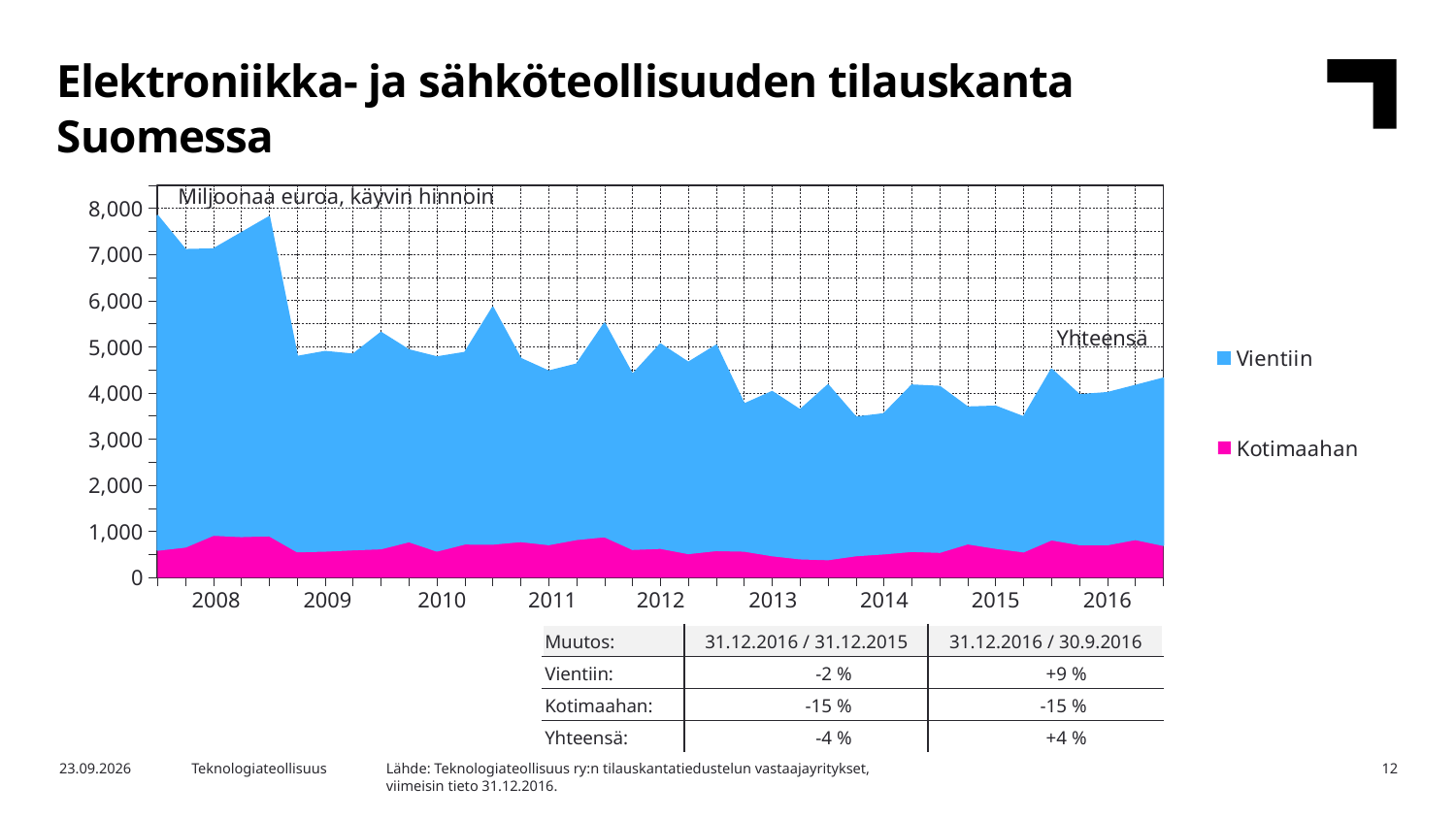
According to the table below the chart, what is the change for Yhteensä between 30.9.2016 and 31.12.2016? +4 % How many series does the chart legend list? 2 Does the total order backlog (Yhteensä) generally rise or fall from 2008 to 2016? Fall What kind of chart is shown on the slide? Stacked area chart What are the two series named in the chart legend? Vientiin and Kotimaahan Which series is larger throughout the chart, Vientiin or Kotimaahan? Vientiin According to the table below the chart, what is the change for Vientiin between 31.12.2015 and 31.12.2016? -2 % Is the total value at the end of 2016 greater or less than 5,000? less Is the Kotimaahan value in 2014 greater or less than 1,000? less Is the total value at the start of 2008 greater or less than 7,000? greater What unit is stated at the top of the chart area? Miljoonaa euroa, käyvin hinnoin How many years are labelled on the x axis of the chart? 9